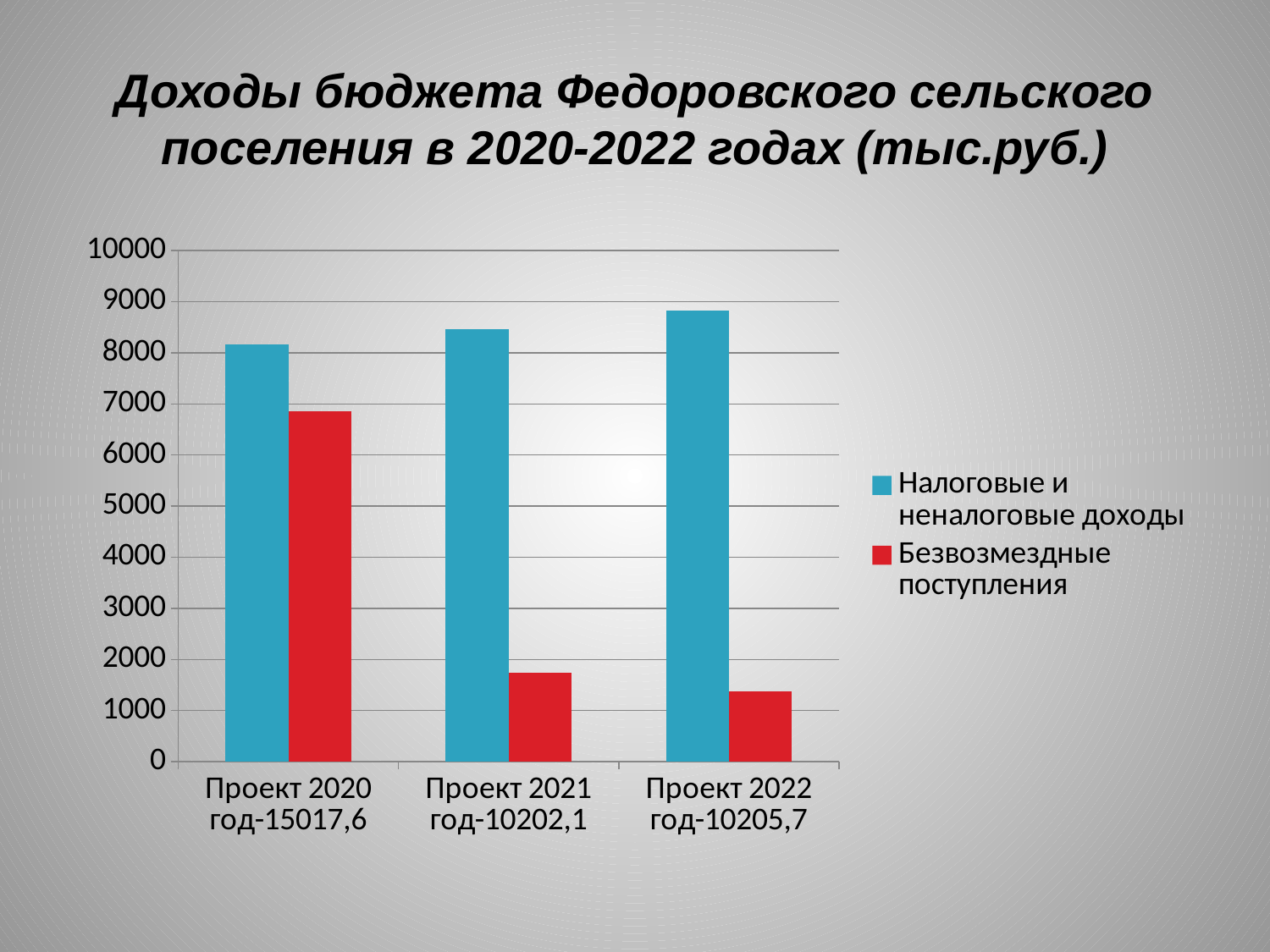
Which category has the highest value for Безвозмездные поступления? Проект 2020 год-15017,6 Which category has the lowest value for Безвозмездные поступления? Проект 2022 год-10205,7 In Проект 2021 год, which series has the larger value: Налоговые и неналоговые доходы or Безвозмездные поступления? Налоговые и неналоговые доходы How many categories are shown on the x axis? 3 How many series does the legend list? 2 Is the value for Безвозмездные поступления in Проект 2021 год greater or less than 2000? less Which category has the highest value for Налоговые и неналоговые доходы? Проект 2022 год-10205,7 What total is printed in the category label for Проект 2021 год? 10202,1 What kind of chart is shown on the slide? bar chart Is the value for Налоговые и неналоговые доходы in Проект 2020 год greater or less than 8000? greater Is the value for Безвозмездные поступления in Проект 2020 год greater or less than 6000? greater Do the values for Безвозмездные поступления rise or fall from Проект 2020 год to Проект 2022 год? fall